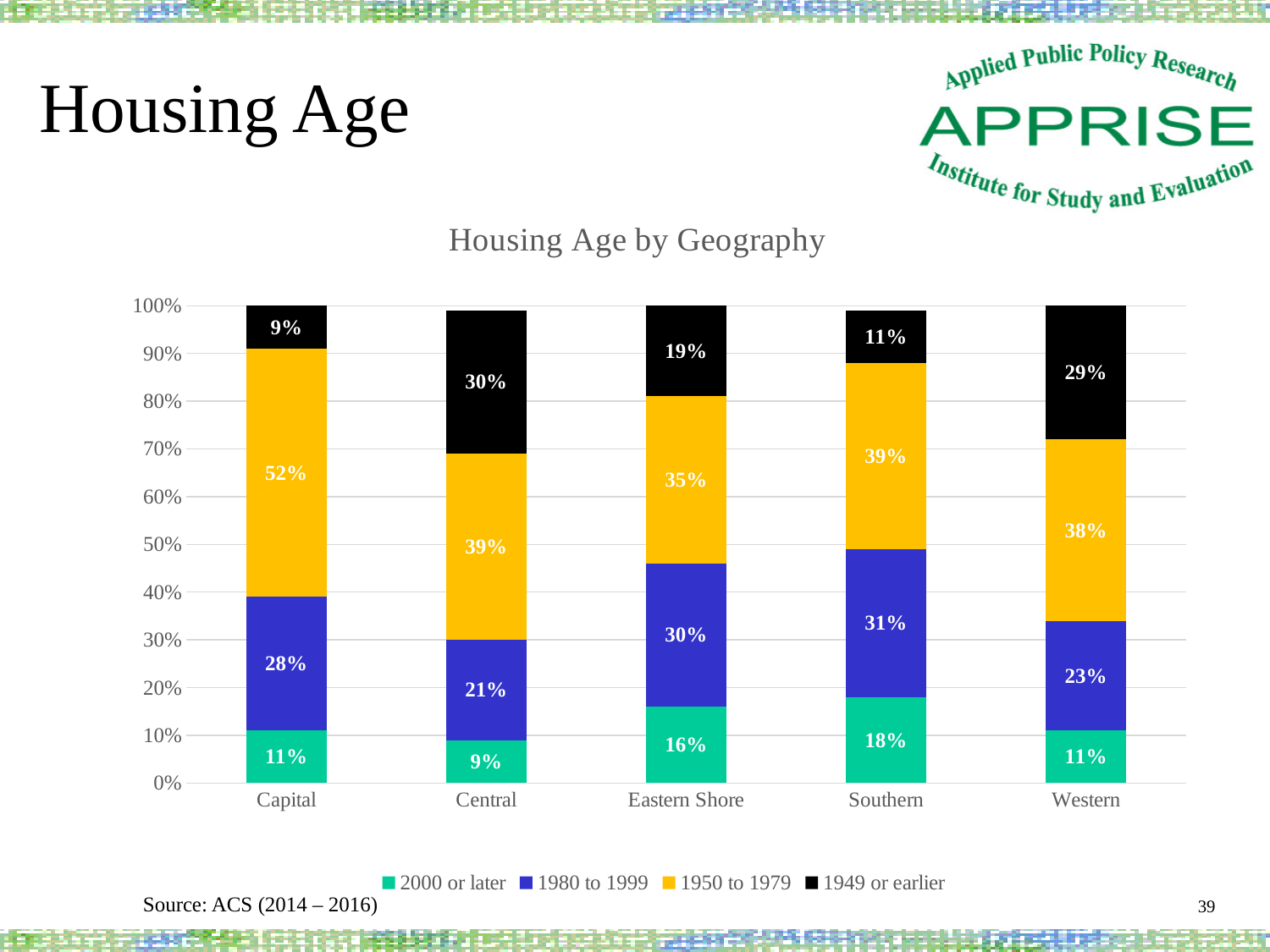
How many series does the legend list? 4 What is the title of the chart? Housing Age by Geography What type of chart is shown? Stacked bar chart What percentage of housing in the Capital region was built between 1950 and 1979? 52% Which geography has the lowest share of housing built in 1949 or earlier? Capital How many geographies are shown on the x axis? 5 What is the difference between the 1980 to 1999 shares for Southern and Central? 10% Which colour represents housing built in 1950 to 1979? Yellow What share of Western housing was built in 1949 or earlier? 29% Which geography has the highest share of housing built in 1949 or earlier? Central Which has a larger share of housing built in 2000 or later, Eastern Shore or Central? Eastern Shore What percentage of Southern housing was built in 2000 or later? 18%